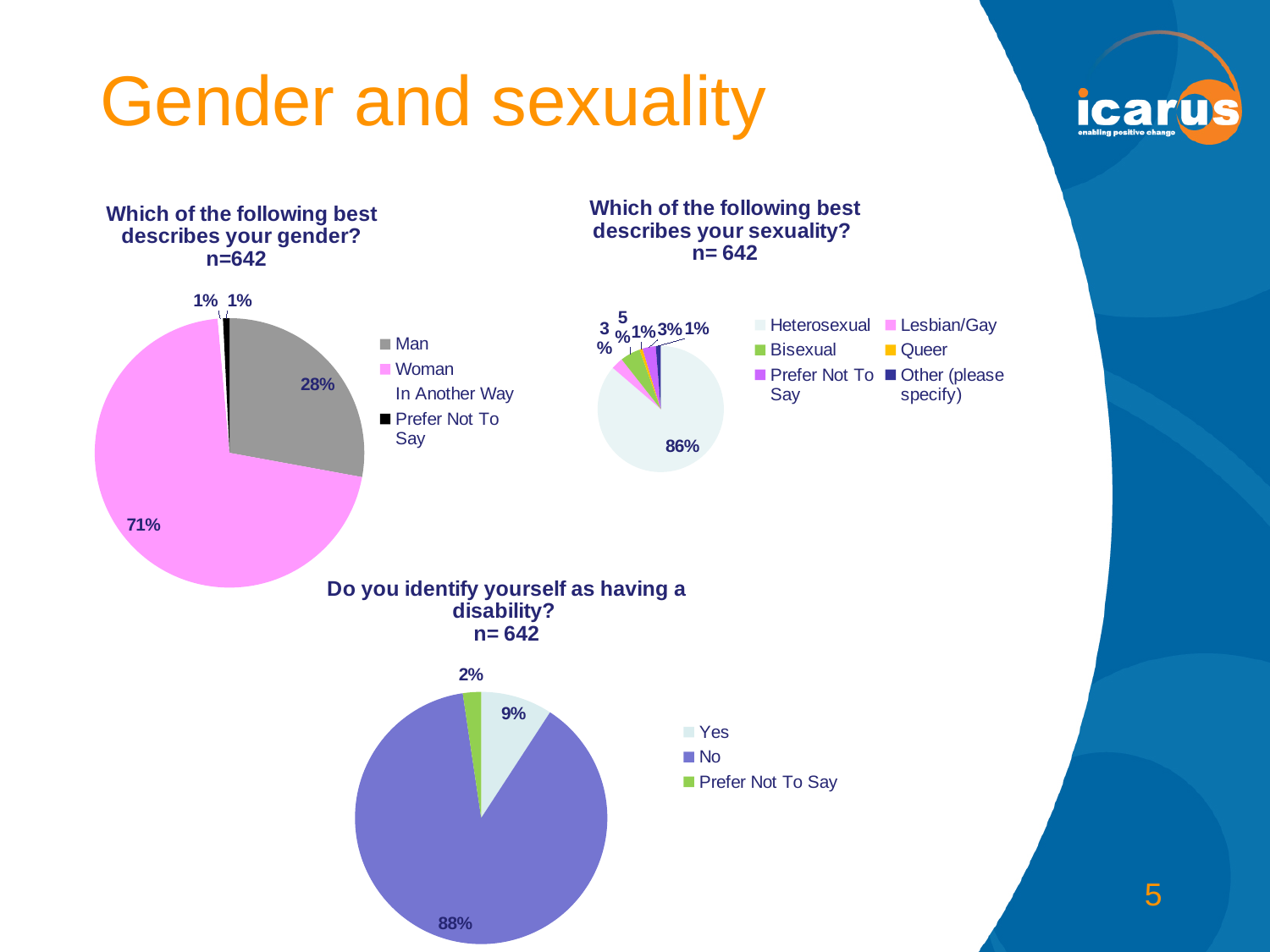
In the chart titled "Which of the following best describes your sexuality?", how many categories does the legend list? 6 In the chart titled "Which of the following best describes your sexuality?", which category has the largest share? Heterosexual In the chart titled "Do you identify yourself as having a disability?", which is larger, the Yes share or the Prefer Not To Say share? Yes In the chart titled "Which of the following best describes your gender?", how many percentage points larger is the Woman share than the Man share? 43 percentage points In the chart titled "Which of the following best describes your gender?", what percentage of respondents answered Woman? 71% In the chart titled "Which of the following best describes your sexuality?", what percentage of respondents answered Heterosexual? 86% In the chart titled "Which of the following best describes your gender?", which category has the largest share? Woman In the chart titled "Do you identify yourself as having a disability?", what percentage of respondents answered No? 88% In the chart titled "Do you identify yourself as having a disability?", what percentage of respondents answered Yes? 9% In the chart titled "Which of the following best describes your gender?", what percentage of respondents answered Man? 28% In the chart titled "Which of the following best describes your gender?", how many categories does the legend list? 4 What kind of chart is the chart titled "Do you identify yourself as having a disability?"? Pie chart